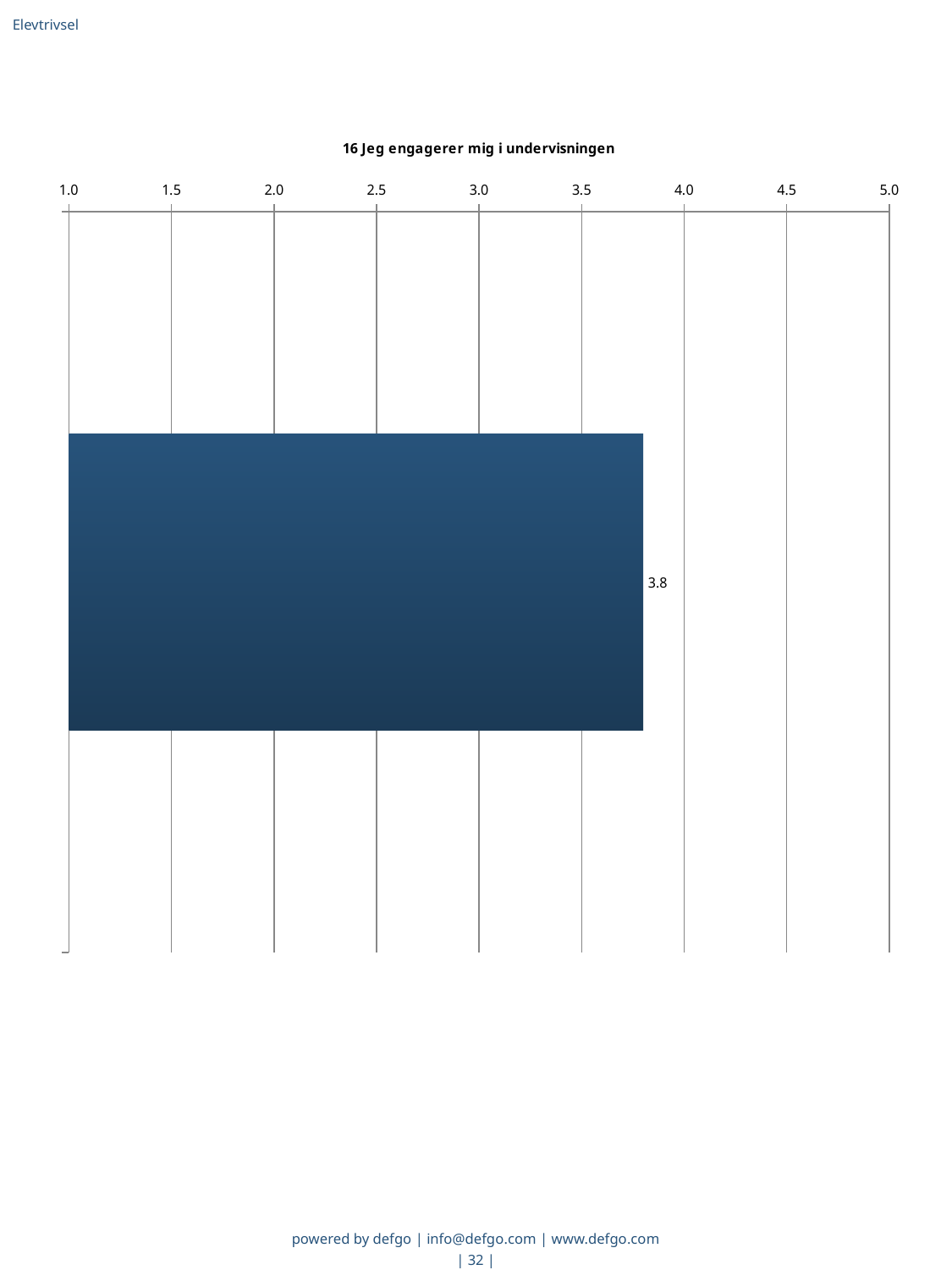
What value is shown by the bar in the chart? 3.8 What kind of chart is shown on the slide? bar chart What is the maximum value shown on the horizontal axis? 5.0 What is the title of the chart? 16 Jeg engagerer mig i undervisningen How many bars are plotted in the chart? 1 Is the value of the bar greater or less than 3.5? greater What is the minimum value shown on the horizontal axis? 1.0 Is the value of the bar greater or less than 4.0? less